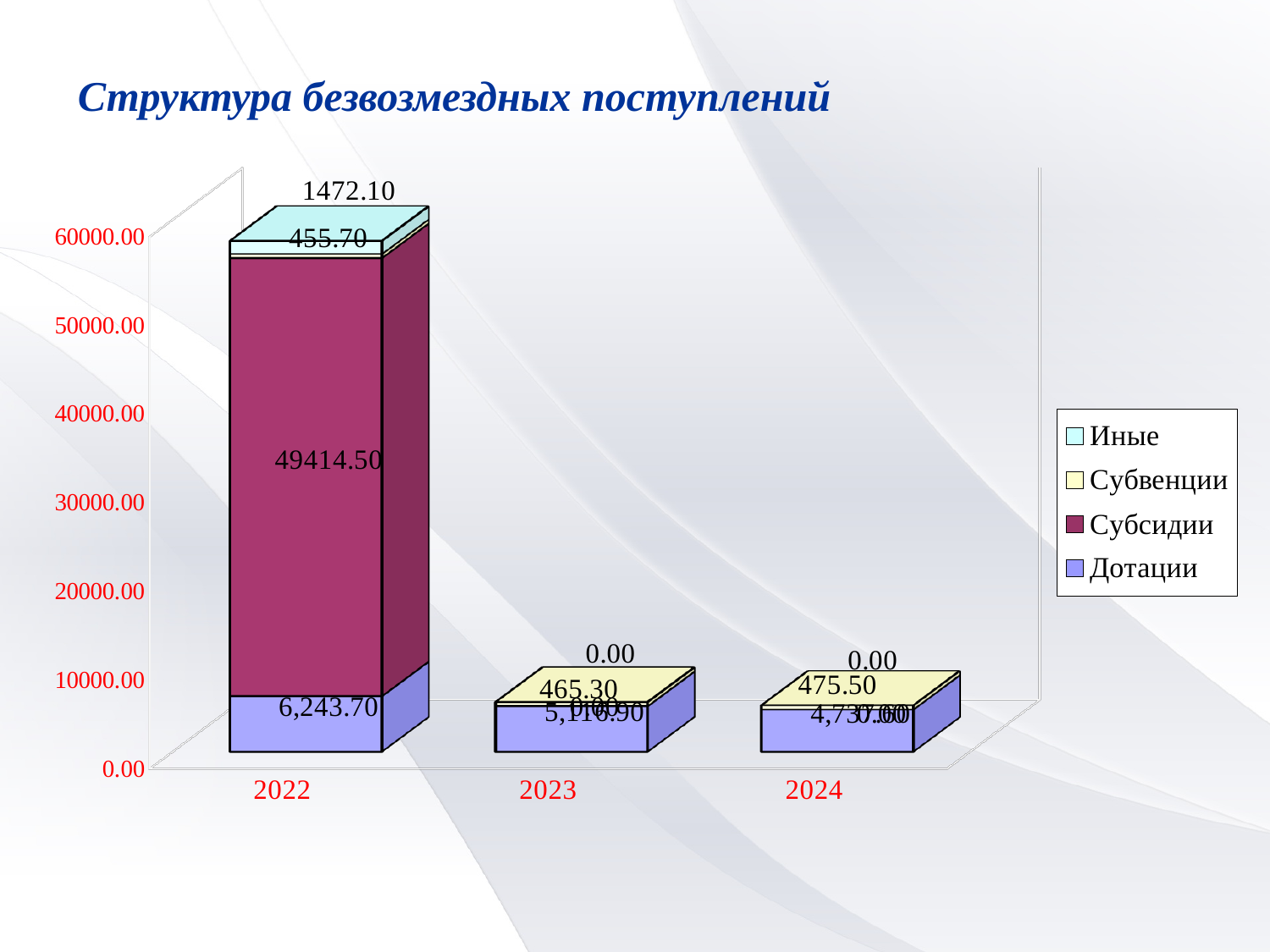
What is the value of Дотации for 2022? 6,243.70 How many years are shown on the x axis? 3 What is the value of Субвенции for 2024? 475.50 What kind of chart is shown on the slide? Stacked bar chart What is the value of Иные for 2022? 1472.10 Is the total stacked value for 2022 greater or less than 50000.00? greater What is the value of Субсидии for 2022? 49414.50 What is the value of Субвенции for 2023? 465.30 How many series does the legend list? 4 What is the difference between Субвенции in 2024 and Субвенции in 2023? 10.20 Which year has the tallest stacked bar? 2022 Which is larger in 2022: Иные or Субвенции? Иные